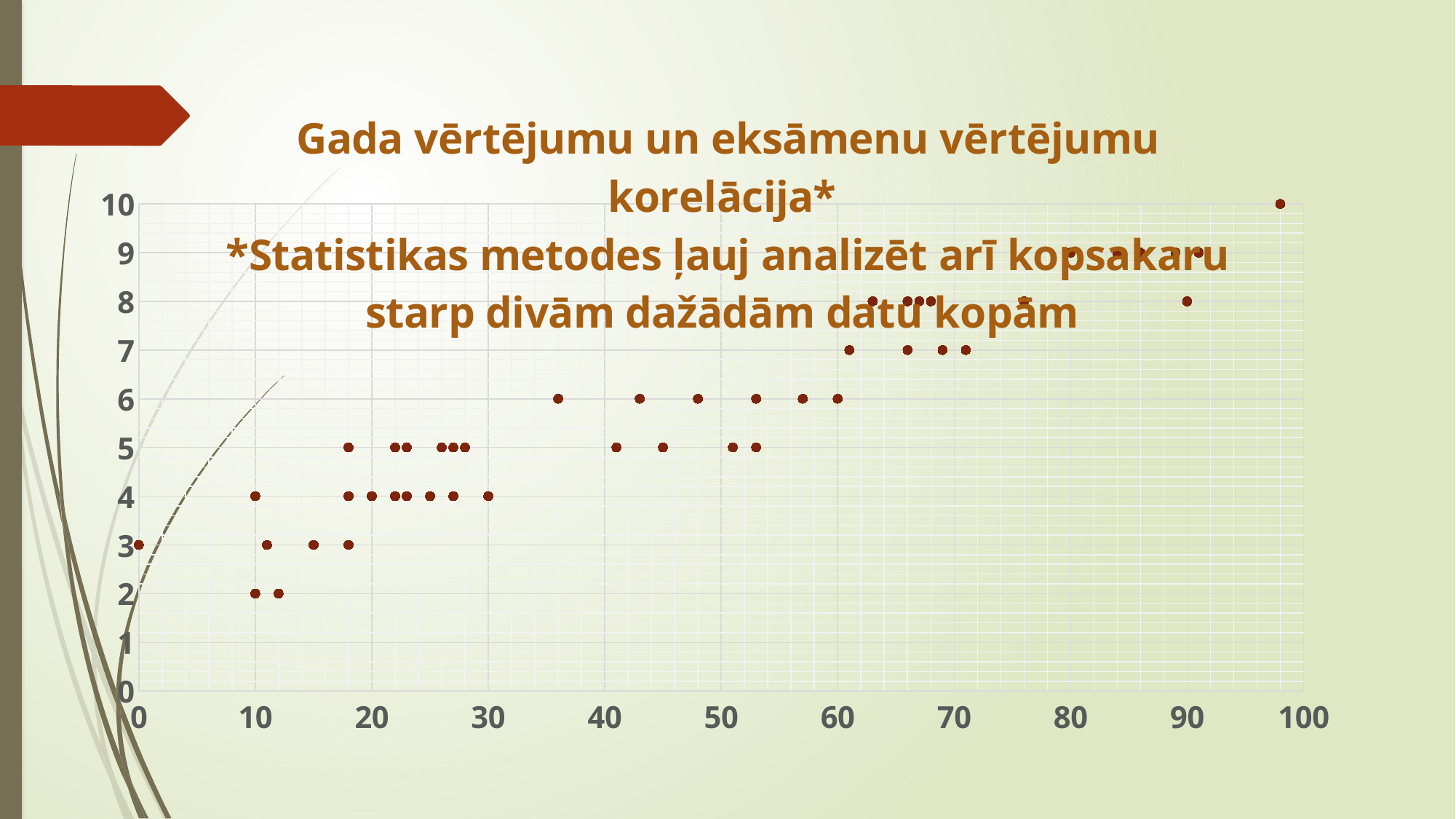
What is the lowest y value reached by any point on the chart? 2 Is the y value of the rightmost point (near x = 100) greater or less than 8? greater As the x values increase, do the y values generally rise or fall? rise What is the y value of the point at x = 90? 8 Is the y value of the point at x = 15 greater or less than 5? less What is the highest y value reached by any point on the chart? 10 What kind of chart is shown on the slide? scatter chart What is the y value of the point at x = 0? 3 Which point has the larger y value: the point at x = 0 or the point at x = 90? the point at x = 90 How many points lie on the y = 10 line? 1 What is the maximum value shown on the x axis? 100 What is the title of the chart? Gada vērtējumu un eksāmenu vērtējumu korelācija* *Statistikas metodes ļauj analizēt arī kopsakaru starp divām dažādām datu kopām